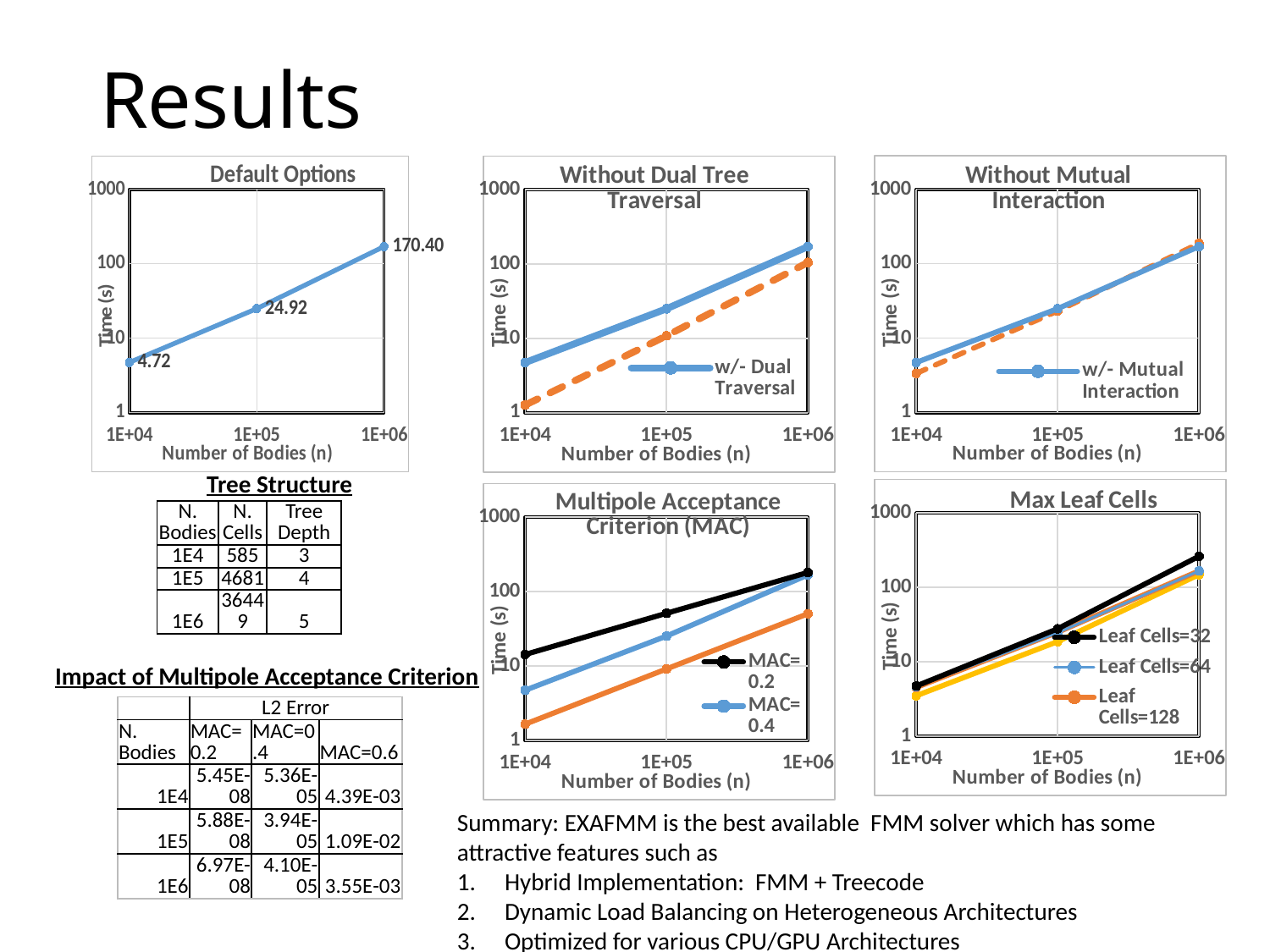
In the 'Default Options' chart, what is the time for 1E+04 bodies? 4.72 In the 'Default Options' chart, what is the time for 1E+06 bodies? 170.40 In the 'Default Options' chart, how many data points are plotted? 3 In the 'Max Leaf Cells' chart, is the value for Leaf Cells=32 at 1E+06 bodies greater or less than 100? greater In the 'Default Options' chart, what is the time for 1E+05 bodies? 24.92 In the 'Multipole Acceptance Criterion (MAC)' chart, at 1E+05 bodies, which series has the higher time: MAC=0.2 or MAC=0.4? MAC=0.2 In the 'Max Leaf Cells' chart, how many series does the legend list? 3 What is the x-axis title of the 'Without Dual Tree Traversal' chart? Number of Bodies (n) What kind of chart is the 'Default Options' chart? line chart In the 'Default Options' chart, does the time rise or fall as the number of bodies increases? rise In the 'Default Options' chart, what is the difference between the time at 1E+06 bodies and the time at 1E+05 bodies? 145.48 In the 'Multipole Acceptance Criterion (MAC)' chart, is the value for MAC=0.2 at 1E+04 bodies greater or less than 10? greater